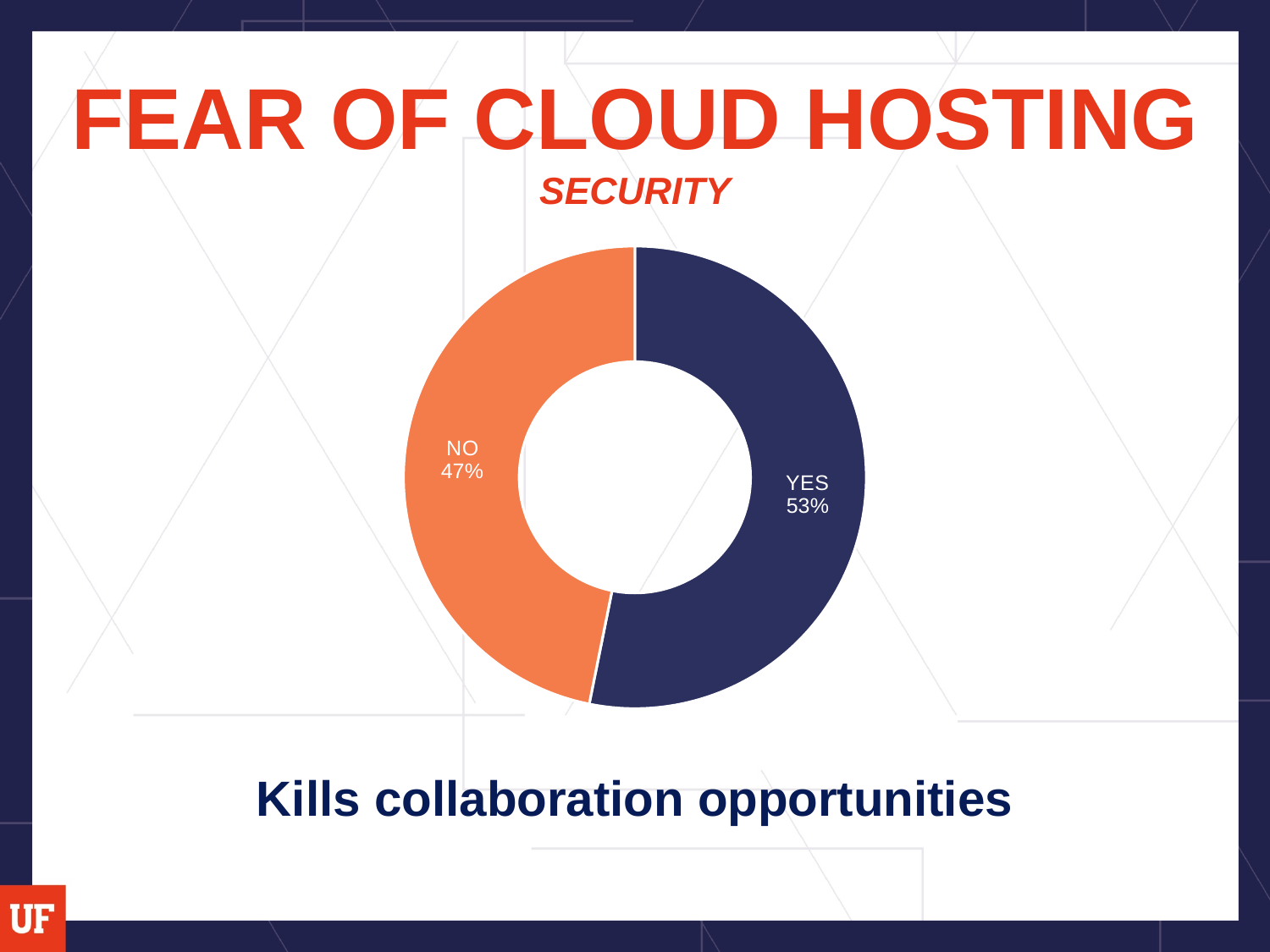
What colour is the YES slice of the pie chart? Dark blue What share of the pie does the NO slice represent? 47% What is the difference in percentage points between the YES and NO slices? 6 What percentage of the pie chart is labelled YES? 53% Which slice is larger, YES or NO? YES What kind of chart is shown on the slide? Doughnut chart Which slice of the pie chart is the smallest? NO What is the subtitle shown directly above the chart? SECURITY Which slice of the pie chart is the largest? YES What percentage of the pie chart is labelled NO? 47% How many slices does the pie chart have? 2